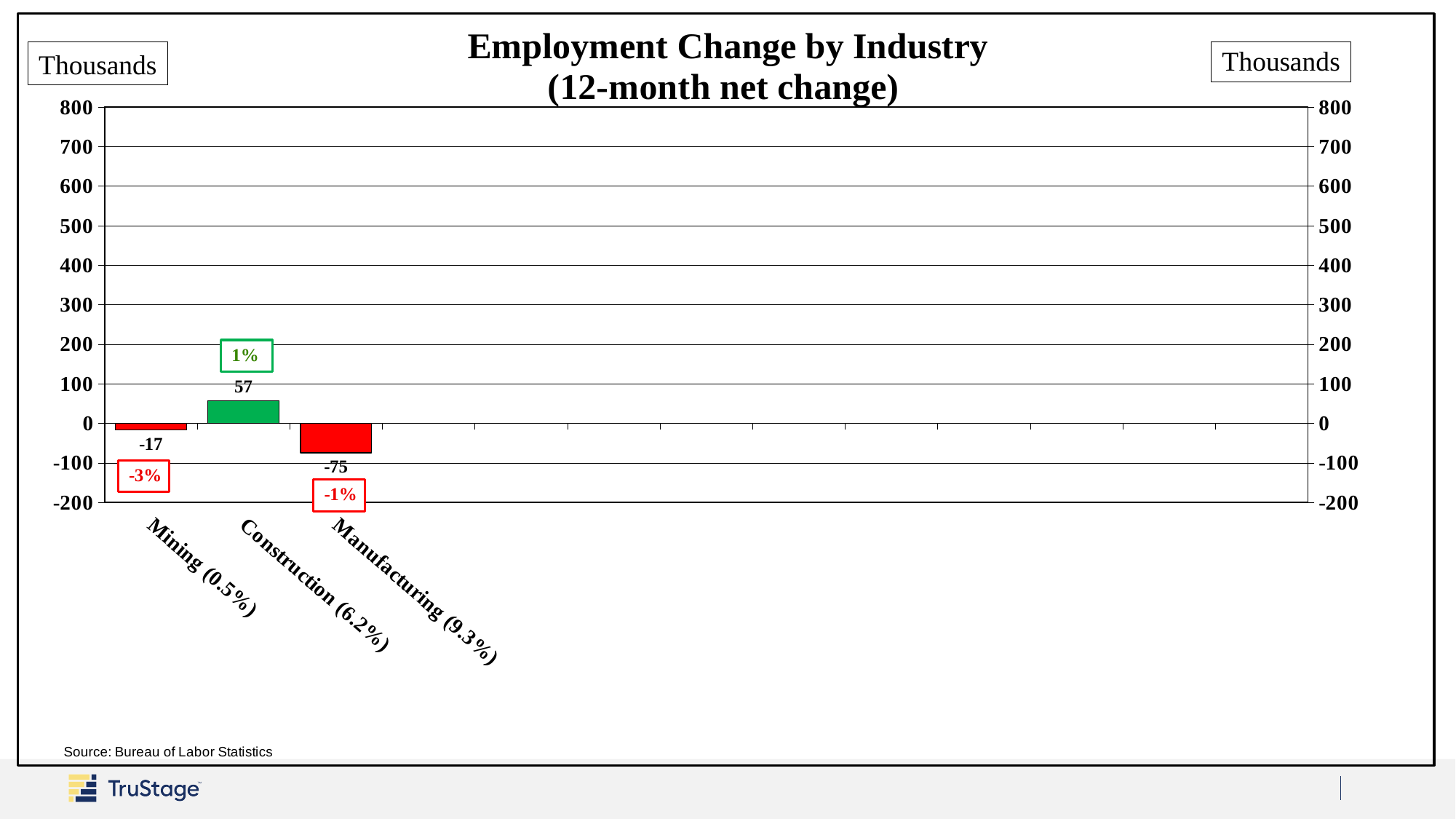
Which industry has the lowest 12-month net employment change? Manufacturing (9.3%) What is the difference between the employment change for Construction (6.2%) and Mining (0.5%)? 74 What kind of chart is shown on the slide? bar chart How many industries are plotted on the chart? 3 What is the title of the chart? Employment Change by Industry (12-month net change) What is the 12-month net employment change for Mining (0.5%)? -17 What is the 12-month net employment change for Construction (6.2%)? 57 What percentage change is shown in the box above the Construction (6.2%) bar? 1% Which industry has the highest 12-month net employment change? Construction (6.2%) Is the value for Construction (6.2%) greater or less than 100? less Which has a larger employment change, Mining (0.5%) or Manufacturing (9.3%)? Mining (0.5%) What is the 12-month net employment change for Manufacturing (9.3%)? -75